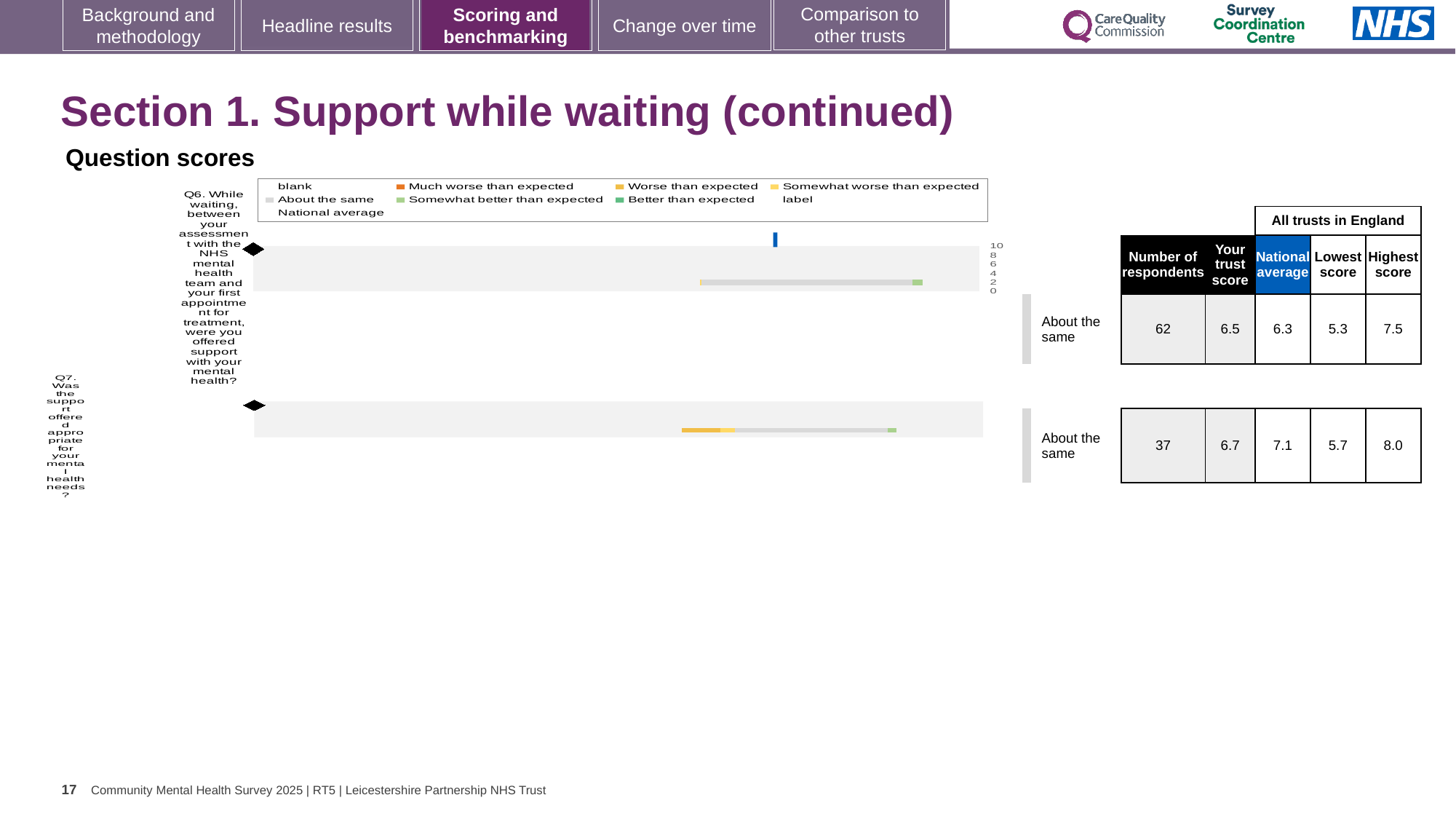
Which question has the higher trust score, Q6 or Q7? Q7 What kind of chart is used to show the question scores on this slide? bar chart What is the difference between the highest and lowest trust scores in England for Q7? 2.3 What is the national average score for Q7 (was the support offered appropriate)? 7.1 For Q7, is the trust score or the national average larger? National average What is the trust score for Q6 (support with mental health while waiting)? 6.5 Which colour does the legend use for 'Better than expected'? green How many respondents answered Q7? 37 What is the highest score across all trusts in England for Q6? 7.5 Is the trust score for Q6 greater or less than 6 on the chart axis? greater What is the highest value shown on the score axis of the chart? 10 How many questions (categories) are plotted in the question scores chart? 2